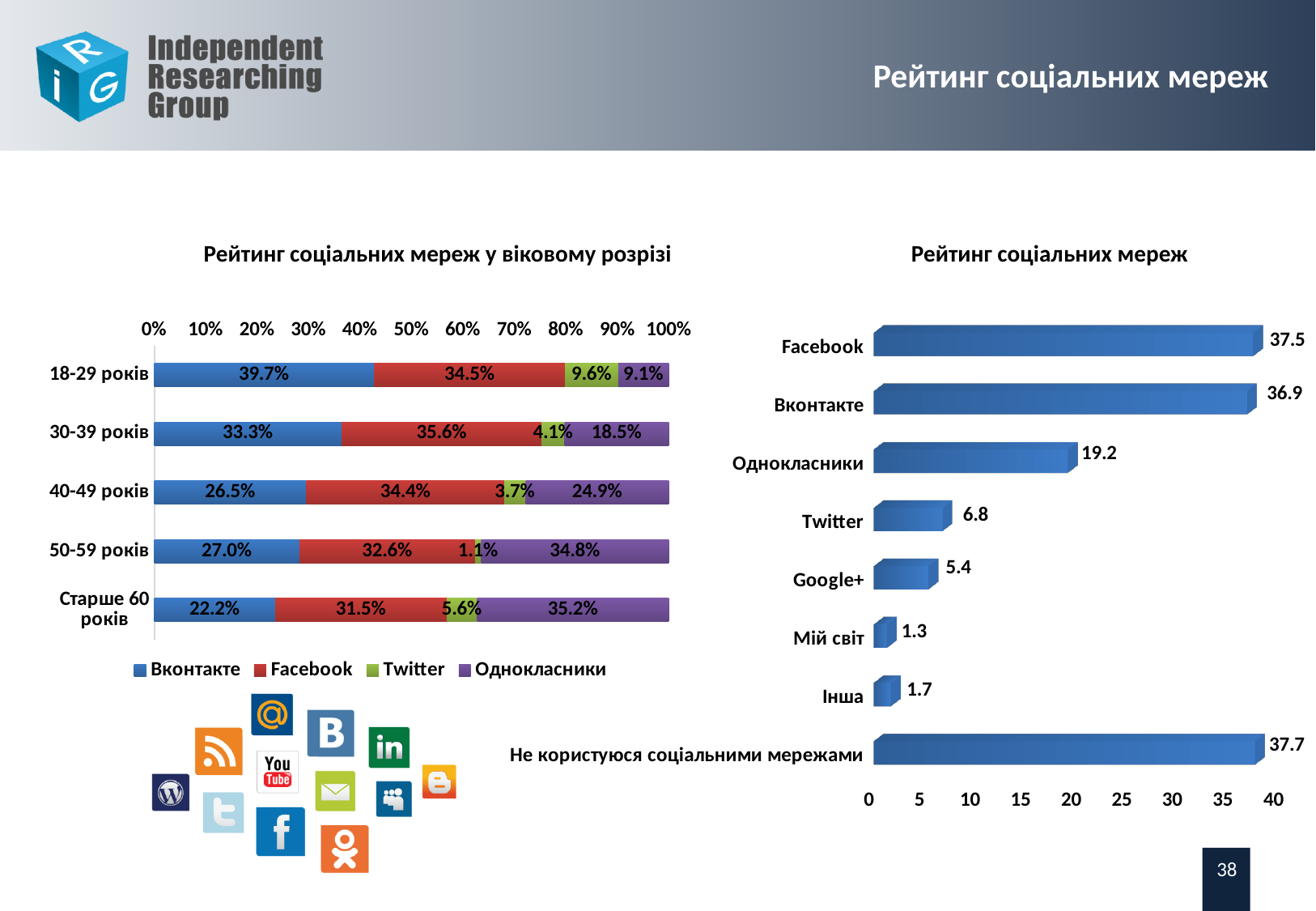
In the chart 'Рейтинг соціальних мереж' on the right, what is the difference between the values for Facebook and Вконтакте? 0.6 In the chart 'Рейтинг соціальних мереж' on the right, what is the value for Facebook? 37.5 In the chart 'Рейтинг соціальних мереж' on the right, which category has the highest value? Не користуюся соціальними мережами In the chart 'Рейтинг соціальних мереж у віковому розрізі' on the left, which age group has the highest Вконтакте share? 18-29 років In the chart 'Рейтинг соціальних мереж' on the right, how many categories are shown? 8 In the chart 'Рейтинг соціальних мереж у віковому розрізі' on the left, what is the Facebook share for the 30-39 років group? 35.6% In the chart 'Рейтинг соціальних мереж у віковому розрізі' on the left, how many series does the legend list? 4 In the chart 'Рейтинг соціальних мереж' on the right, is the value for Одноклассники greater or less than 20? less In the chart 'Рейтинг соціальних мереж' on the right, what is the value for Twitter? 6.8 What kind of chart is 'Рейтинг соціальних мереж у віковому розрізі' on the left? Stacked bar chart In the chart 'Рейтинг соціальних мереж у віковому розрізі' on the left, what is the Одноклассники share for the Старше 60 років group? 35.2% In the chart 'Рейтинг соціальних мереж' on the right, which category has the lowest value? Мій світ